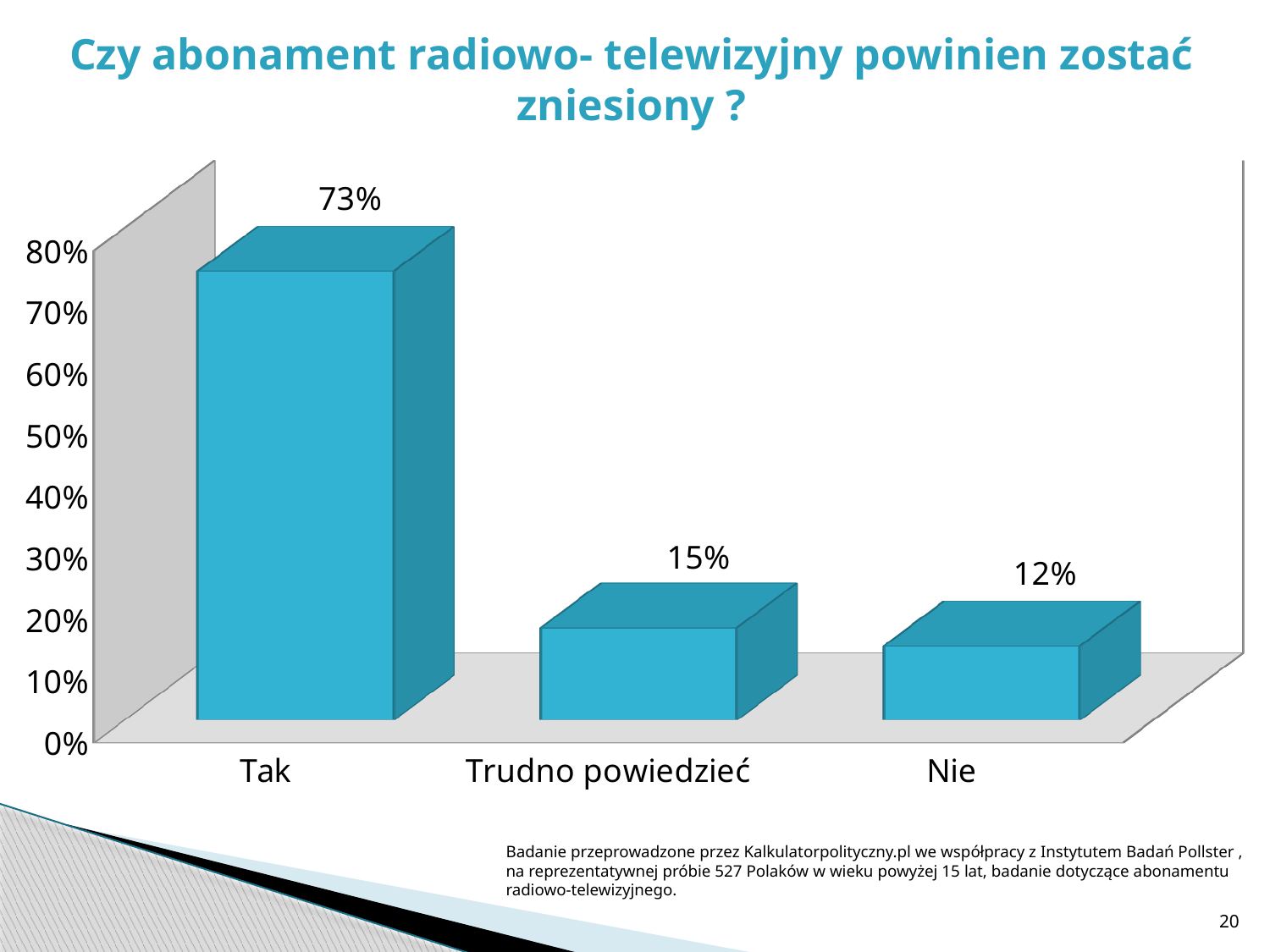
What is the value for "Tak"? 73% What is the title of the chart? Czy abonament radiowo- telewizyjny powinien zostać zniesiony ? What is the value for "Trudno powiedzieć"? 15% What is the difference between the values for "Trudno powiedzieć" and "Nie"? 3% What is the difference between the values for "Tak" and "Nie"? 61% How many categories are shown on the chart? 3 Is the value for "Tak" greater or less than 50%? greater What is the value for "Nie"? 12% Which is larger, the value for "Trudno powiedzieć" or the value for "Nie"? Trudno powiedzieć Which category has the lowest value? Nie What kind of chart is shown on the slide? bar chart Which category has the highest value? Tak